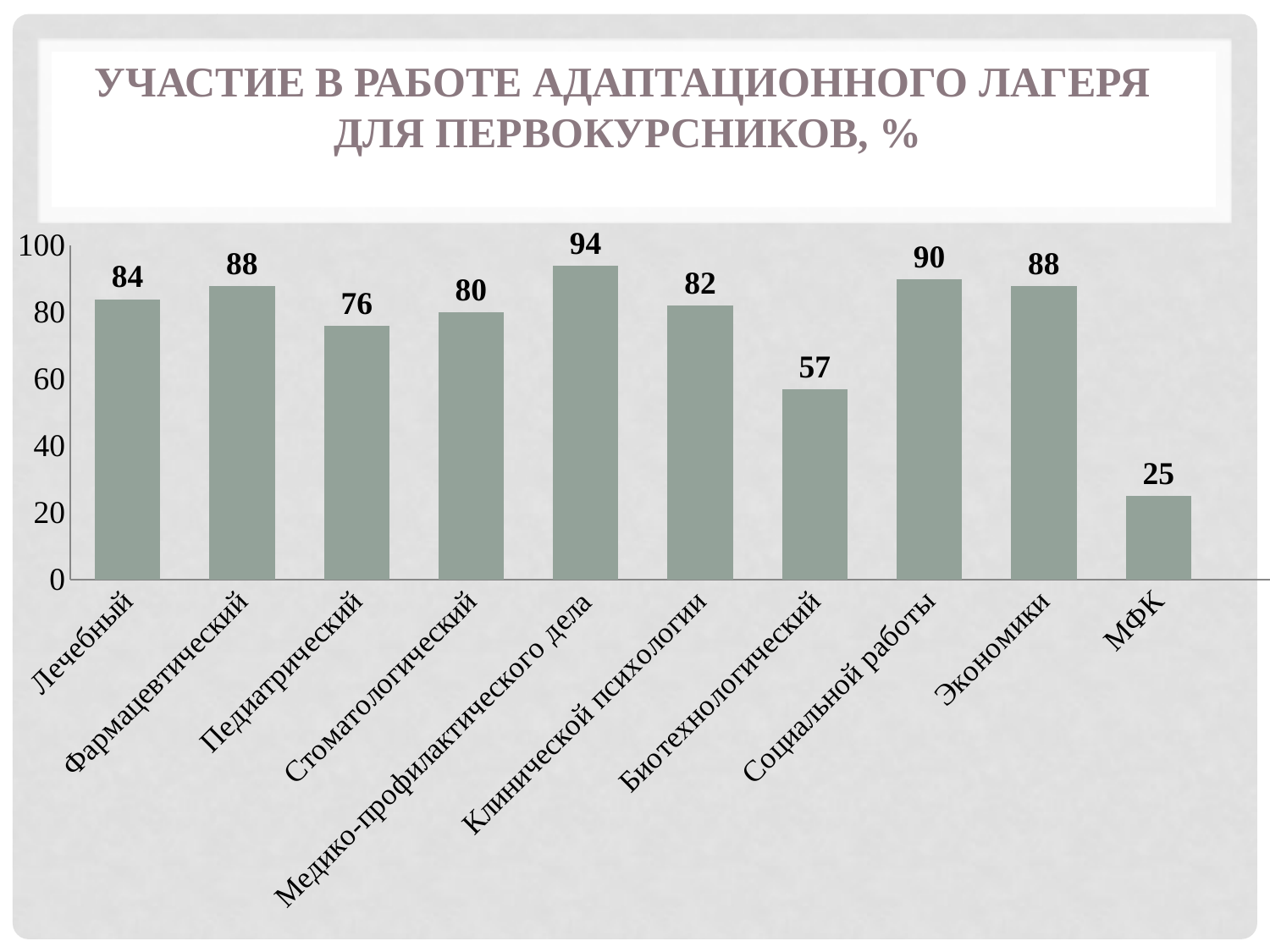
What is the difference between the values for Социальной работы and Педиатрический? 14 Which two categories share the value 88? Фармацевтический and Экономики How many categories are shown on the chart? 10 Is the value for Биотехнологический greater or less than 60? less What is the value for Лечебный? 84 What is the title of the chart? Участие в работе адаптационного лагеря для первокурсников, % What is the value for Биотехнологический? 57 What kind of chart is shown on the slide? bar chart Which category has the lowest value? МФК What is the value for МФК? 25 Which is larger, the value for Стоматологический or the value for Клинической психологии? Клинической психологии Which category has the highest value? Медико-профилактического дела